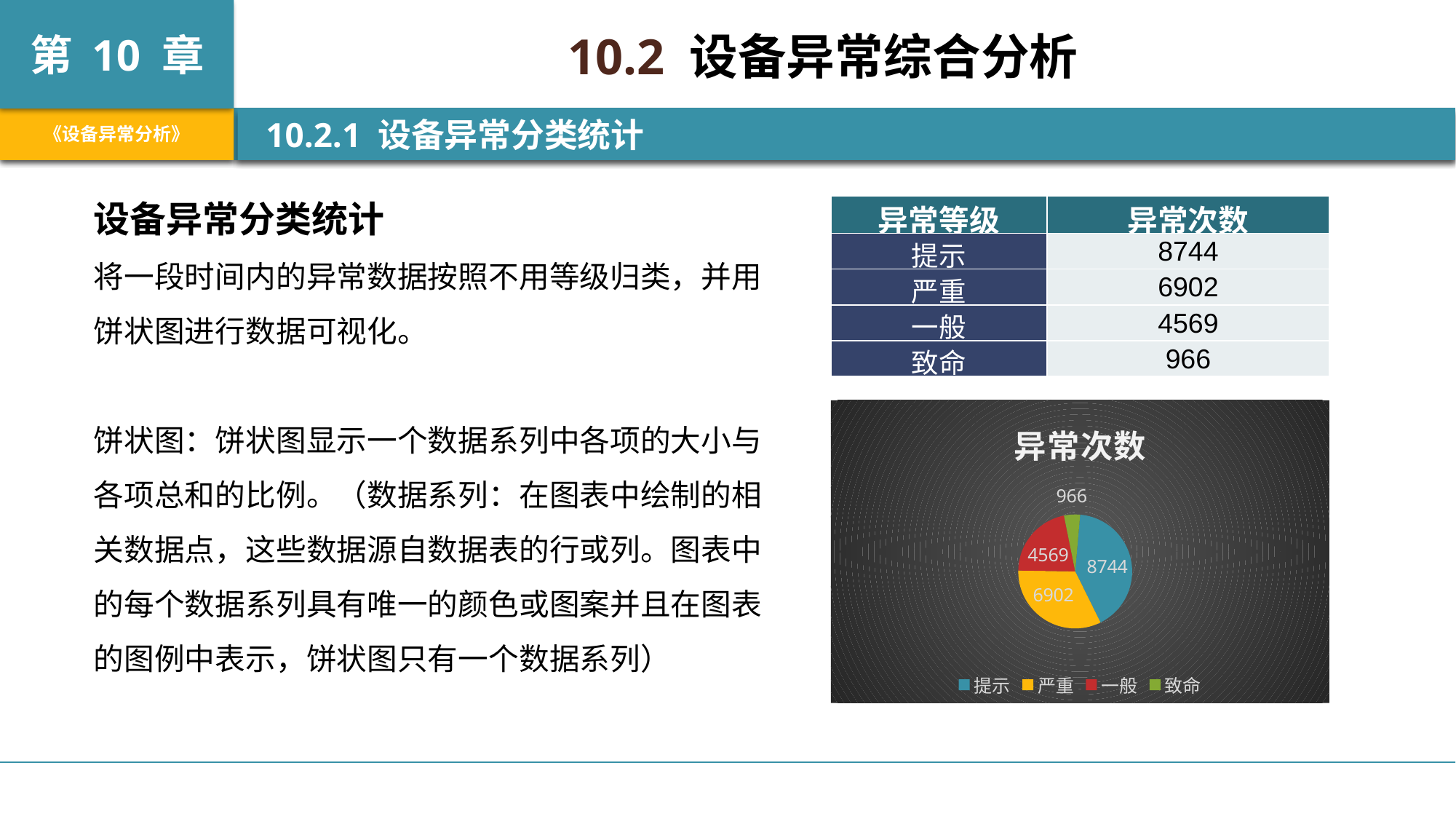
What type of chart is shown on the slide? pie chart What is the value for 严重 in the pie chart? 6902 What is the title of the chart? 异常次数 How many entries does the legend list? 4 How many slices does the pie chart have? 4 Which is larger, the value for 一般 or the value for 致命? 一般 Which category has the largest slice in the pie chart? 提示 What is the difference between the values for 提示 and 严重? 1842 What is the value for 一般 in the pie chart? 4569 What is the value for 提示 in the pie chart? 8744 What is the value for 致命 in the pie chart? 966 Which category has the smallest slice in the pie chart? 致命